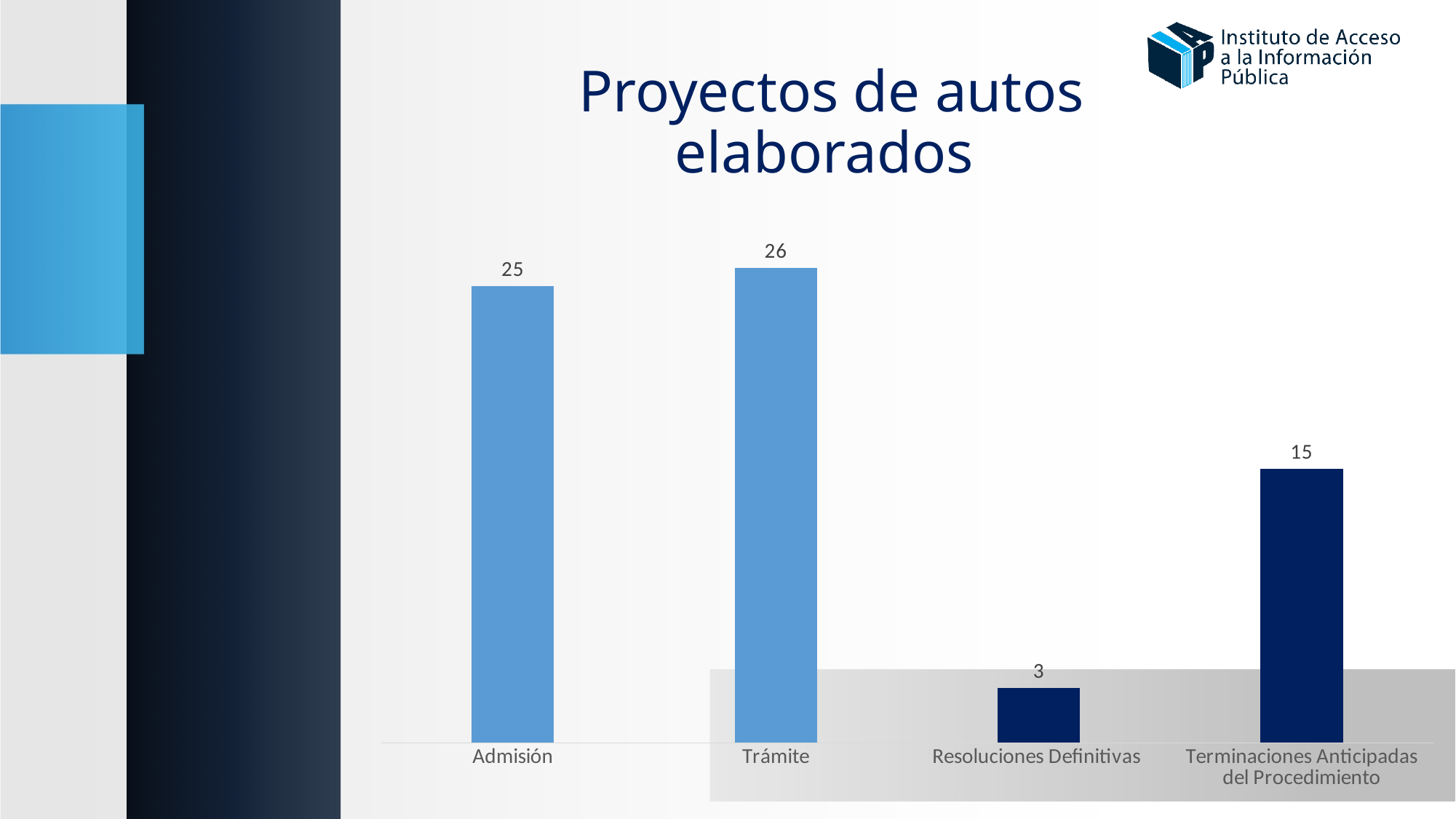
What is the difference between the values for Admisión and Terminaciones Anticipadas del Procedimiento? 10 What is the value for Terminaciones Anticipadas del Procedimiento? 15 What is the title of the slide? Proyectos de autos elaborados What is the difference between the values for Trámite and Admisión? 1 Which category has the highest value? Trámite What kind of chart is shown on the slide? Bar chart Which category has the lowest value? Resoluciones Definitivas How many categories are shown in the chart? 4 What is the value for Admisión? 25 Which is larger, the value for Terminaciones Anticipadas del Procedimiento or the value for Resoluciones Definitivas? Terminaciones Anticipadas del Procedimiento What is the value for Trámite? 26 What is the value for Resoluciones Definitivas? 3